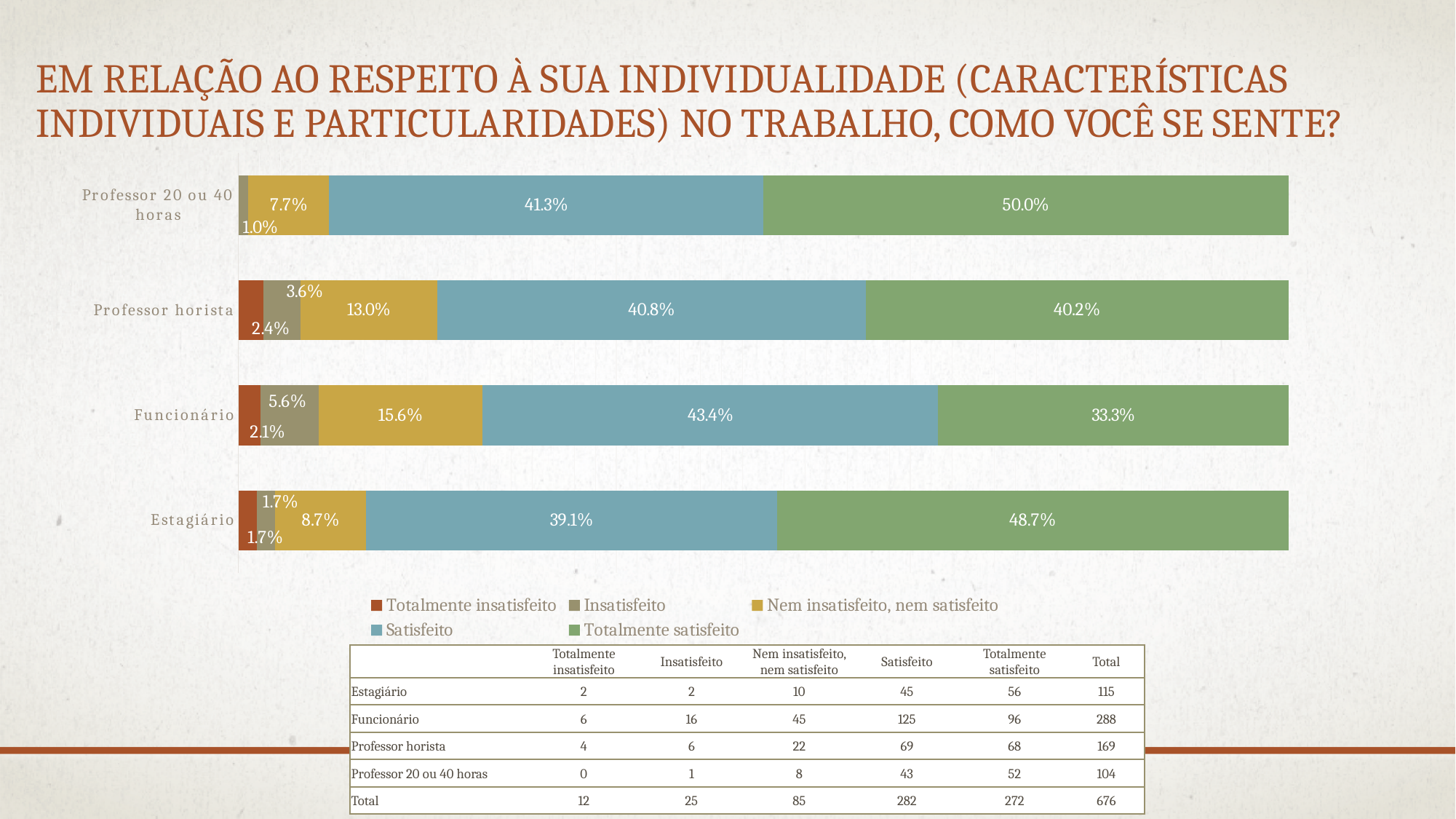
What is the 'Satisfeito' value for 'Funcionário'? 43.4% How many categories are shown on the chart? 4 How many series does the legend list? 5 What kind of chart is shown on the slide? Stacked bar chart What is the 'Nem insatisfeito, nem satisfeito' value for 'Professor horista'? 13.0% What is the 'Totalmente insatisfeito' value for 'Professor horista'? 2.4% Which category has the highest 'Totalmente satisfeito' percentage? Professor 20 ou 40 horas What percentage of 'Professor 20 ou 40 horas' respondents are 'Totalmente satisfeito'? 50.0% Which category has the highest 'Nem insatisfeito, nem satisfeito' percentage? Funcionário Which category has the lowest 'Totalmente satisfeito' percentage? Funcionário For 'Professor horista', which is larger: 'Satisfeito' or 'Totalmente satisfeito'? Satisfeito What is the difference between the 'Satisfeito' values for 'Funcionário' and 'Estagiário'? 4.3 percentage points